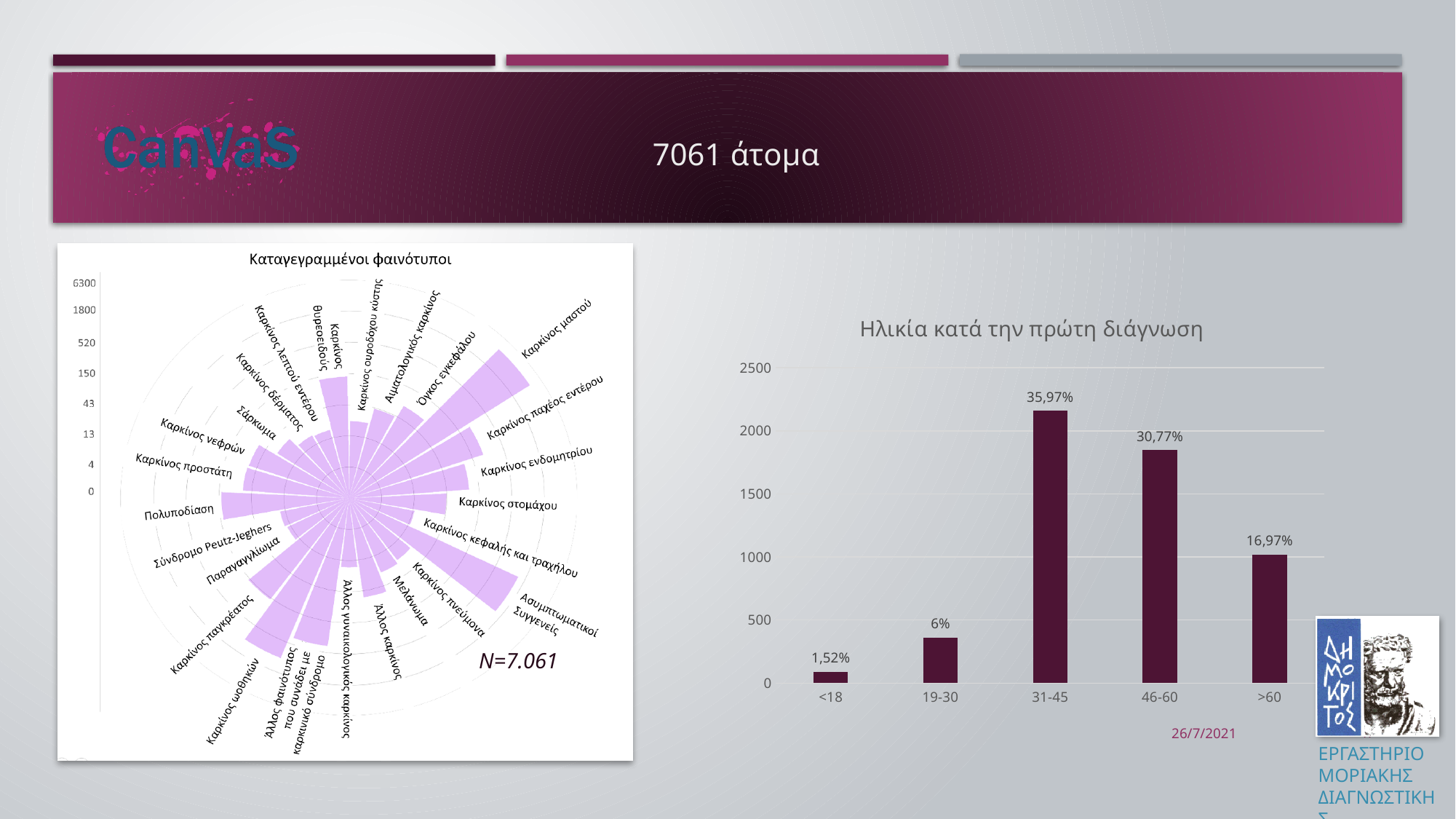
In the 'Ηλικία κατά την πρώτη διάγνωση' chart, is the value for 19-30 greater or less than 500? less In the 'Ηλικία κατά την πρώτη διάγνωση' chart, which is larger, the bar for 46-60 or the bar for >60? 46-60 In the 'Ηλικία κατά την πρώτη διάγνωση' chart, which age group has the lowest bar? <18 In the 'Ηλικία κατά την πρώτη διάγνωση' chart, what percentage label is shown for the <18 age group? 1,52% What type of chart is the 'Ηλικία κατά την πρώτη διάγνωση' chart on the right? bar chart In the 'Ηλικία κατά την πρώτη διάγνωση' chart, is the value for 31-45 greater or less than 2000? greater In the 'Ηλικία κατά την πρώτη διάγνωση' chart, how many age categories are shown on the x axis? 5 In the 'Ηλικία κατά την πρώτη διάγνωση' chart, which age group has the highest bar? 31-45 What sample size (N) is printed on the 'Καταγεγραμμένοι φαινότυποι' chart on the left? N=7.061 In the 'Ηλικία κατά την πρώτη διάγνωση' chart, what percentage label is shown for the >60 age group? 16,97% In the 'Καταγεγραμμένοι φαινότυποι' chart on the left, which phenotype has the longest bar? Καρκίνος μαστού In the 'Ηλικία κατά την πρώτη διάγνωση' chart, what percentage label is shown for the 31-45 age group? 35,97%